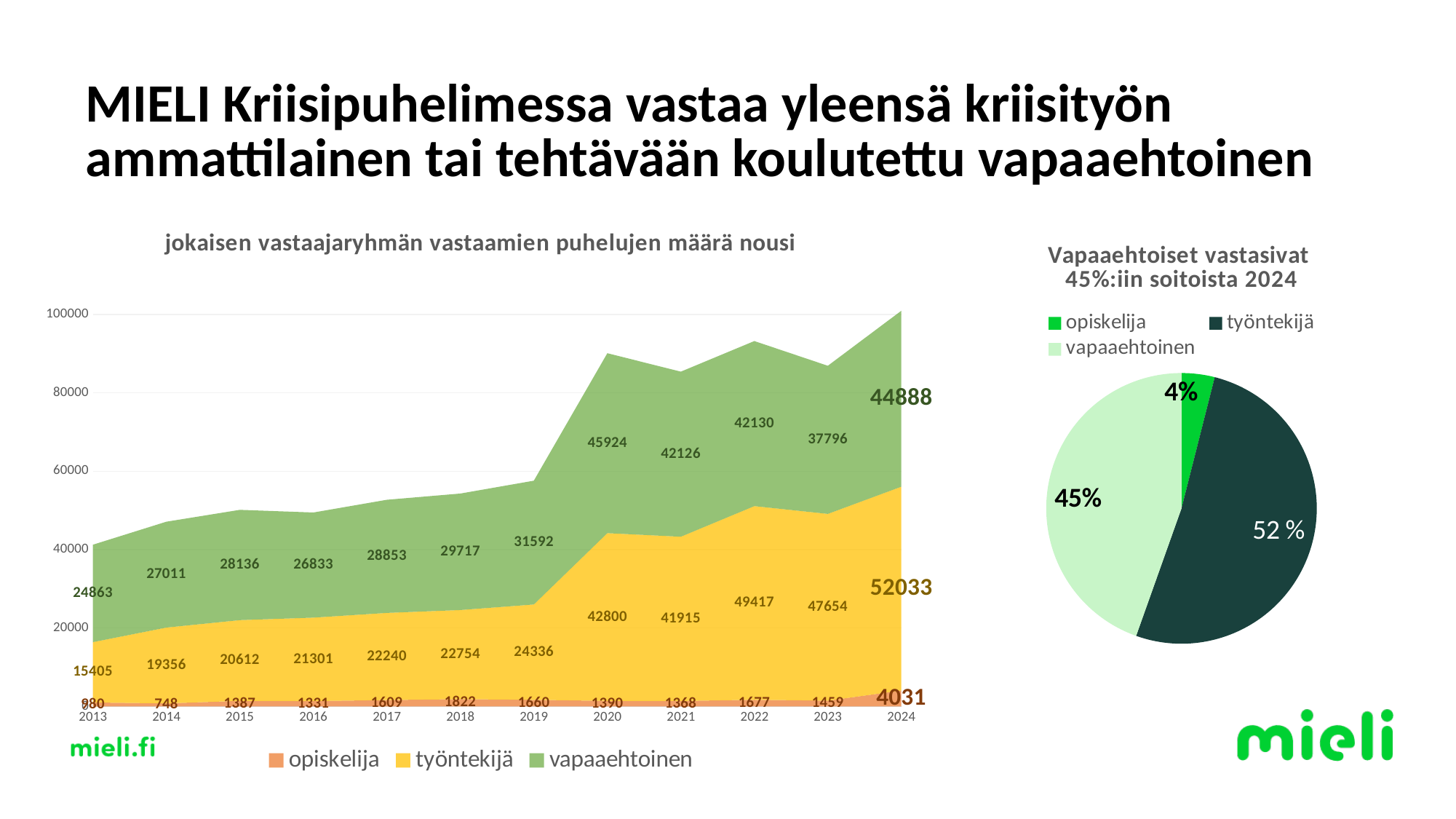
In the left chart, which is larger in 2021: the työntekijä value or the vapaaehtoinen value? vapaaehtoinen In the left chart, in which year is the vapaaehtoinen value highest? 2020 What kind of chart is the chart on the left titled 'jokaisen vastaajaryhmän vastaamien puhelujen määrä nousi'? Stacked area chart In the left chart, how many series does the legend list? 3 In the pie chart titled 'Vapaaehtoiset vastasivat 45%:iin soitoista 2024', what share does vapaaehtoinen have? 45% In the left chart, how many years are shown on the x axis? 12 In the left chart, what is the total of the three series in 2024? 100952 In the left chart, what is the value for opiskelija in 2024? 4031 In the pie chart on the right, which category has the smallest slice? opiskelija In the left chart, what is the difference between the työntekijä values for 2024 and 2023? 4379 In the left chart, what is the value for työntekijä in 2024? 52033 In the left chart, what is the value for vapaaehtoinen in 2020? 45924